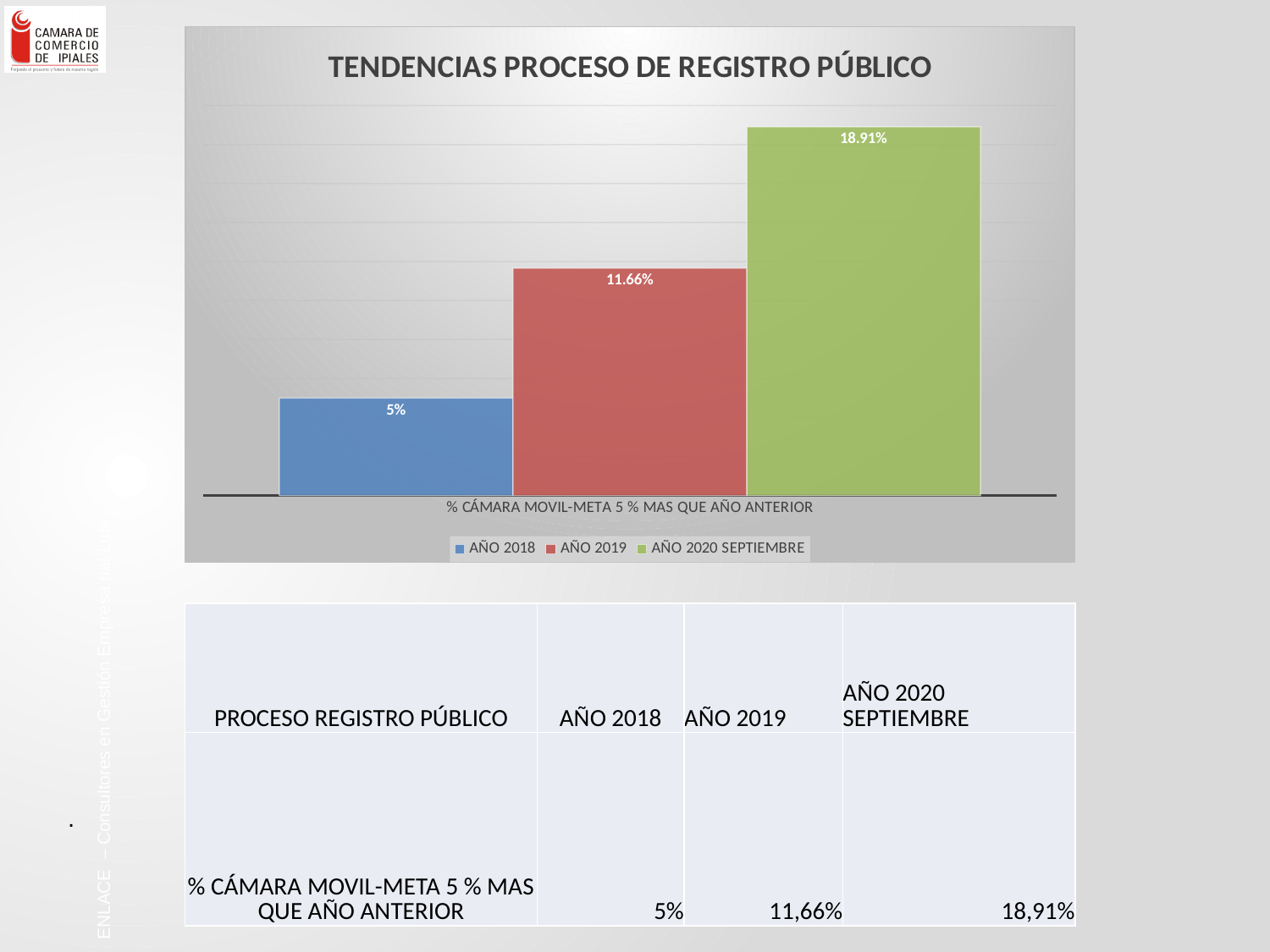
What is the difference between the AÑO 2019 value and the AÑO 2018 value? 6.66% What is the value for AÑO 2019 in the chart? 11.66% How many series does the legend list? 3 Which series has the highest value in the chart? AÑO 2020 SEPTIEMBRE What kind of chart is shown on the slide? Bar chart What is the value for AÑO 2018 in the chart? 5% Which series has the lowest value in the chart? AÑO 2018 What is the value for AÑO 2020 SEPTIEMBRE in the chart? 18.91% What is the title of the chart? TENDENCIAS PROCESO DE REGISTRO PÚBLICO Do the values rise or fall from AÑO 2018 to AÑO 2020 SEPTIEMBRE? Rise Which is larger, the value for AÑO 2019 or the value for AÑO 2018? AÑO 2019 What is the difference between the AÑO 2020 SEPTIEMBRE value and the AÑO 2019 value? 7.25%